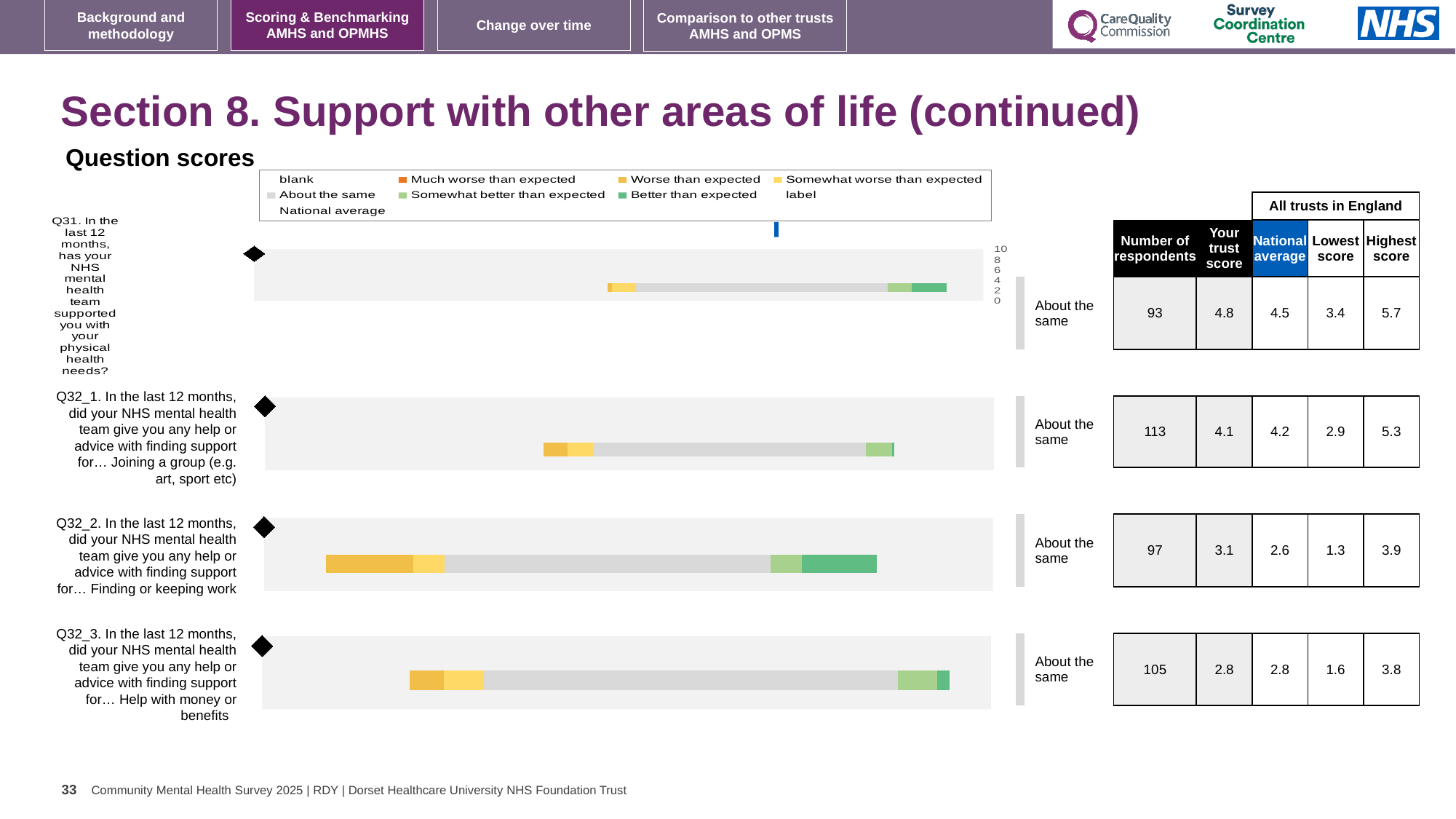
What kind of chart is used to show the Q31 question score? bar chart Which colour in the legend represents 'Better than expected'? green In the table beside the Q32_3 chart (Help with money or benefits), what is the highest score? 3.8 What heading appears above the charts? Question scores In the table beside the Q31 chart, what is the 'Your trust score' value? 4.8 In the table beside the Q32_2 chart (Finding or keeping work), what is the national average? 2.6 For Q32_2 (Finding or keeping work), which is larger: the trust score or the national average? the trust score What is the difference between the highest score and the lowest score for Q31 in the table? 2.3 How many question score charts are shown on the slide? 4 In the table beside the Q32_1 chart (Joining a group), what is the number of respondents? 113 What category label is shown to the right of the Q32_2 chart (Finding or keeping work)? About the same How many entries does the legend above the charts list? 9